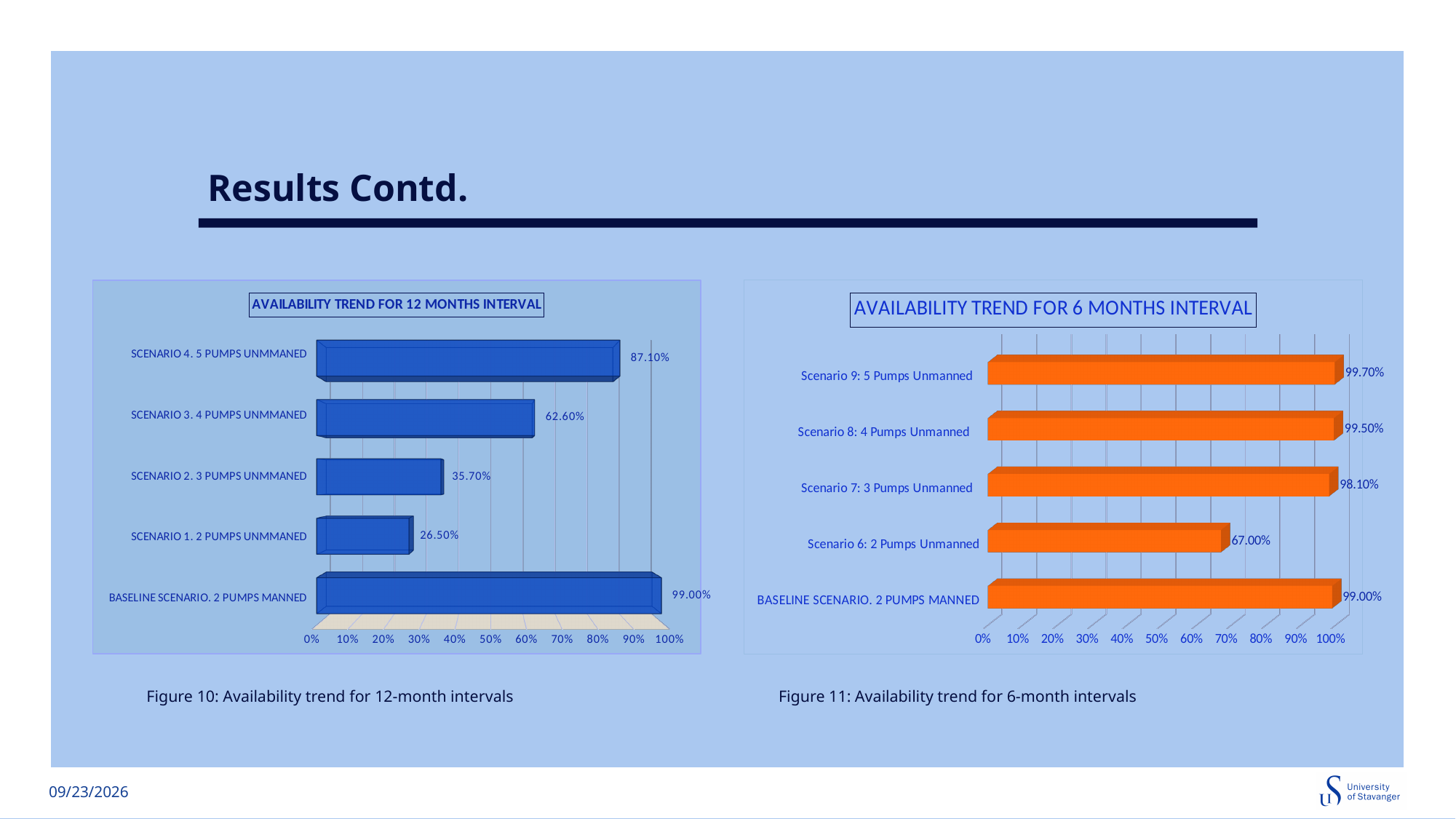
In the 'AVAILABILITY TREND FOR 12 MONTHS INTERVAL' chart, which category has the highest value? BASELINE SCENARIO. 2 PUMPS MANNED In the 'AVAILABILITY TREND FOR 12 MONTHS INTERVAL' chart, which category has the lowest value? SCENARIO 1. 2 PUMPS UNMMANED In the 'AVAILABILITY TREND FOR 12 MONTHS INTERVAL' chart, what is the value for SCENARIO 1. 2 PUMPS UNMMANED? 26.50% In the 'AVAILABILITY TREND FOR 6 MONTHS INTERVAL' chart, what is the value for Scenario 7: 3 Pumps Unmanned? 98.10% In the 'AVAILABILITY TREND FOR 6 MONTHS INTERVAL' chart, what is the difference between Scenario 9: 5 Pumps Unmanned and BASELINE SCENARIO. 2 PUMPS MANNED? 0.70% In the 'AVAILABILITY TREND FOR 12 MONTHS INTERVAL' chart, how many categories are shown? 5 In the 'AVAILABILITY TREND FOR 6 MONTHS INTERVAL' chart, which category has the highest value? Scenario 9: 5 Pumps Unmanned What kind of chart is the 'AVAILABILITY TREND FOR 6 MONTHS INTERVAL' chart? Bar chart In the 'AVAILABILITY TREND FOR 12 MONTHS INTERVAL' chart, what is the value for SCENARIO 4. 5 PUMPS UNMMANED? 87.10% In the 'AVAILABILITY TREND FOR 6 MONTHS INTERVAL' chart, which is larger: Scenario 8: 4 Pumps Unmanned or Scenario 6: 2 Pumps Unmanned? Scenario 8: 4 Pumps Unmanned In the 'AVAILABILITY TREND FOR 6 MONTHS INTERVAL' chart, what is the value for Scenario 6: 2 Pumps Unmanned? 67.00% In the 'AVAILABILITY TREND FOR 12 MONTHS INTERVAL' chart, what is the difference between SCENARIO 3. 4 PUMPS UNMMANED and SCENARIO 2. 3 PUMPS UNMMANED? 26.90%